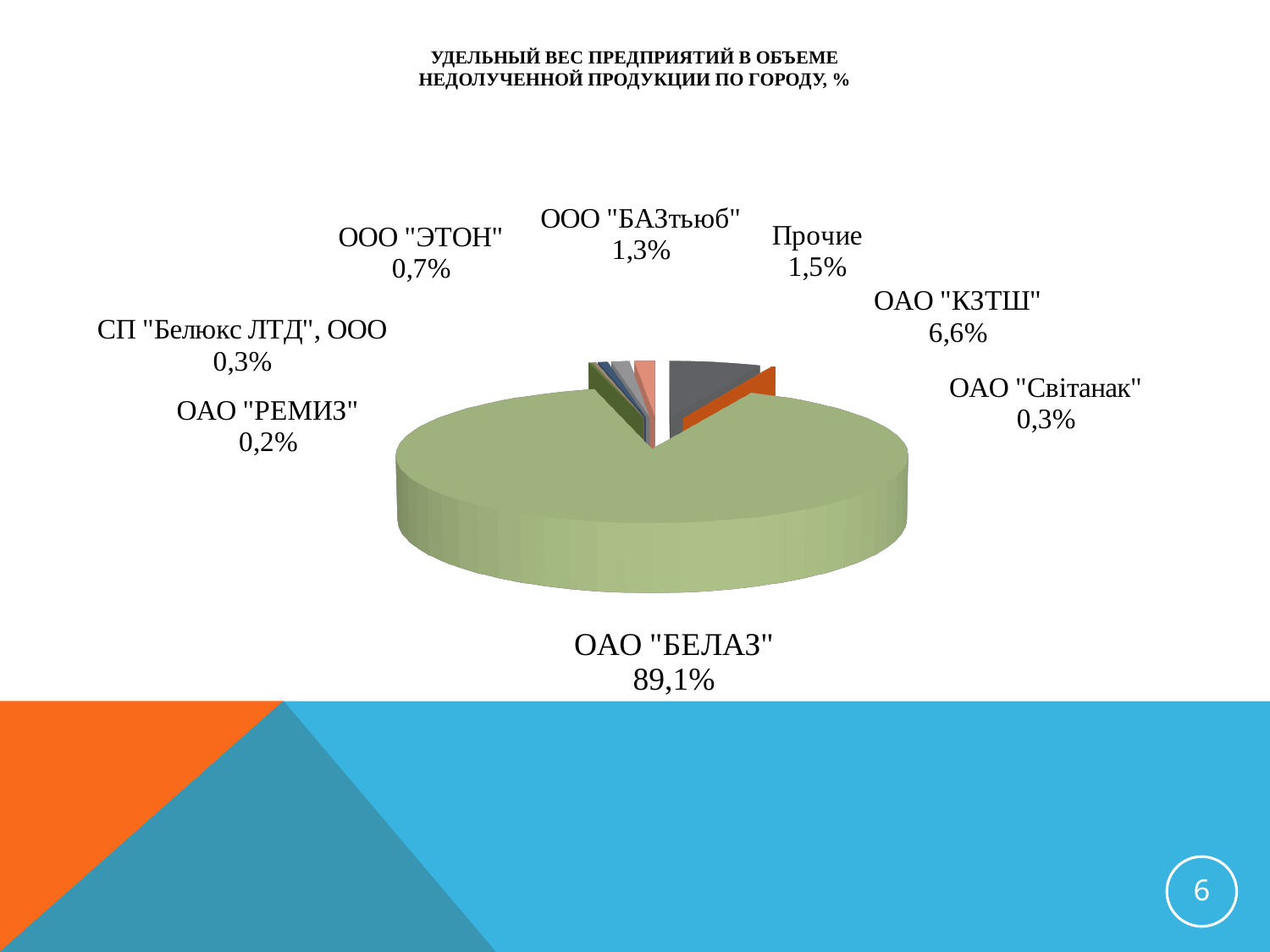
What is the value shown for Прочие? 1,5% What is the title of the chart? УДЕЛЬНЫЙ ВЕС ПРЕДПРИЯТИЙ В ОБЪЕМЕ НЕДОЛУЧЕННОЙ ПРОДУКЦИИ ПО ГОРОДУ, % How many categories (slices) are labelled in the pie chart? 8 What kind of chart is shown on the slide? pie chart Which enterprise has the smallest share in the pie chart? ОАО "РЕМИЗ" Which has a larger share, ООО "БАЗтьюб" or ООО "ЭТОН"? ООО "БАЗтьюб" What share does ОАО "БЕЛАЗ" have in the pie chart? 89,1% What is the value shown for ОАО "КЗТШ"? 6,6% What is the value shown for ООО "БАЗтьюб"? 1,3% What is the difference between the shares of ОАО "КЗТШ" and Прочие? 5,1% What is the value shown for ООО "ЭТОН"? 0,7% Which enterprise has the largest share in the pie chart? ОАО "БЕЛАЗ"